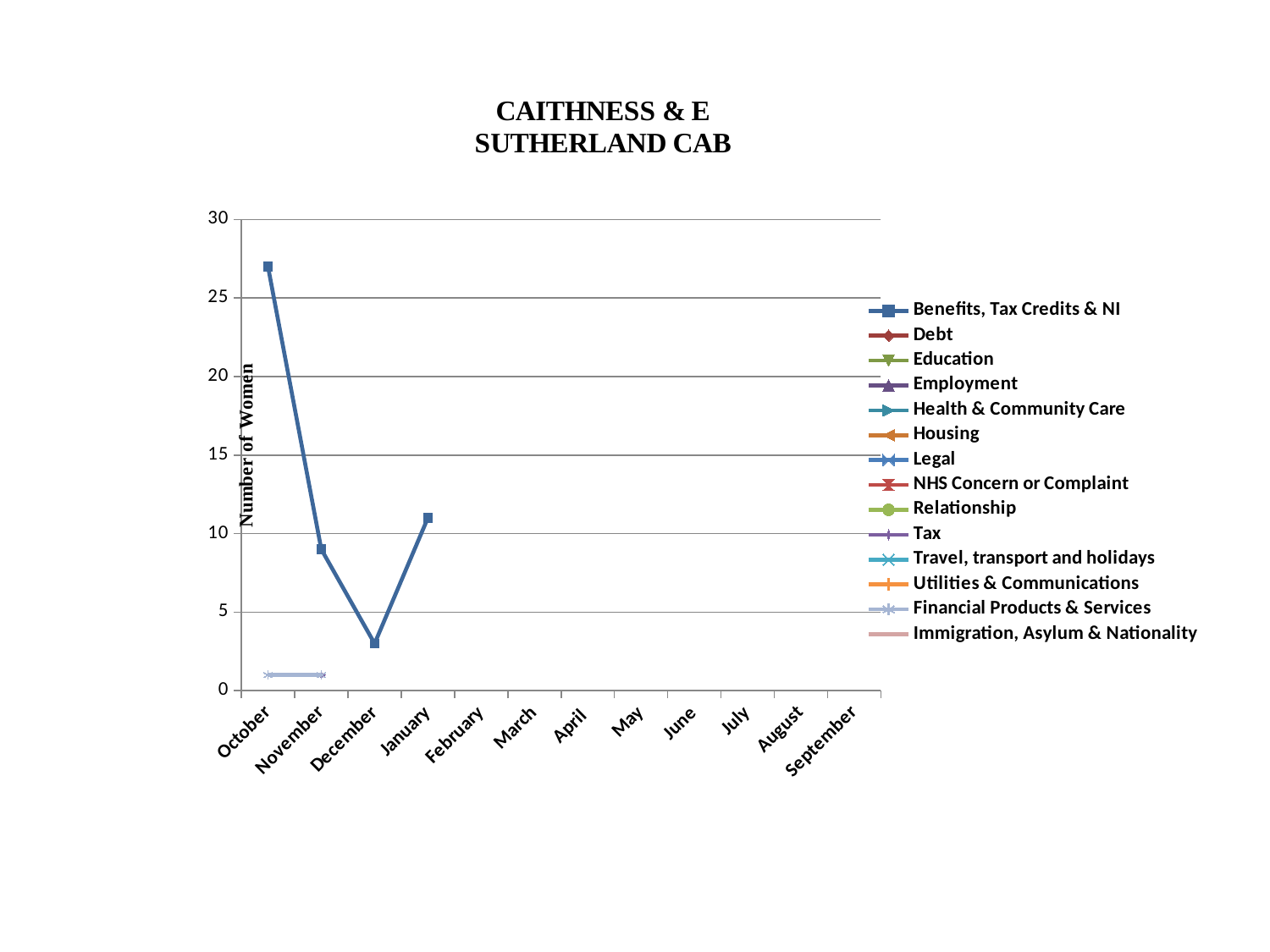
What is the label on the vertical axis? Number of Women Among the months with plotted values, in which month is the value for Benefits, Tax Credits & NI lowest? December How many series does the legend list? 14 Which is larger for Benefits, Tax Credits & NI: the value in October or the value in January? October Does the Benefits, Tax Credits & NI line rise or fall from October to December? fall In which month is the value for Benefits, Tax Credits & NI highest? October Is the value for Benefits, Tax Credits & NI in December greater or less than 5? less Is the value for Benefits, Tax Credits & NI in November greater or less than 15? less Is the value for Benefits, Tax Credits & NI in October greater or less than 25? greater What kind of chart is shown on the slide? line chart How many months are shown along the x axis? 12